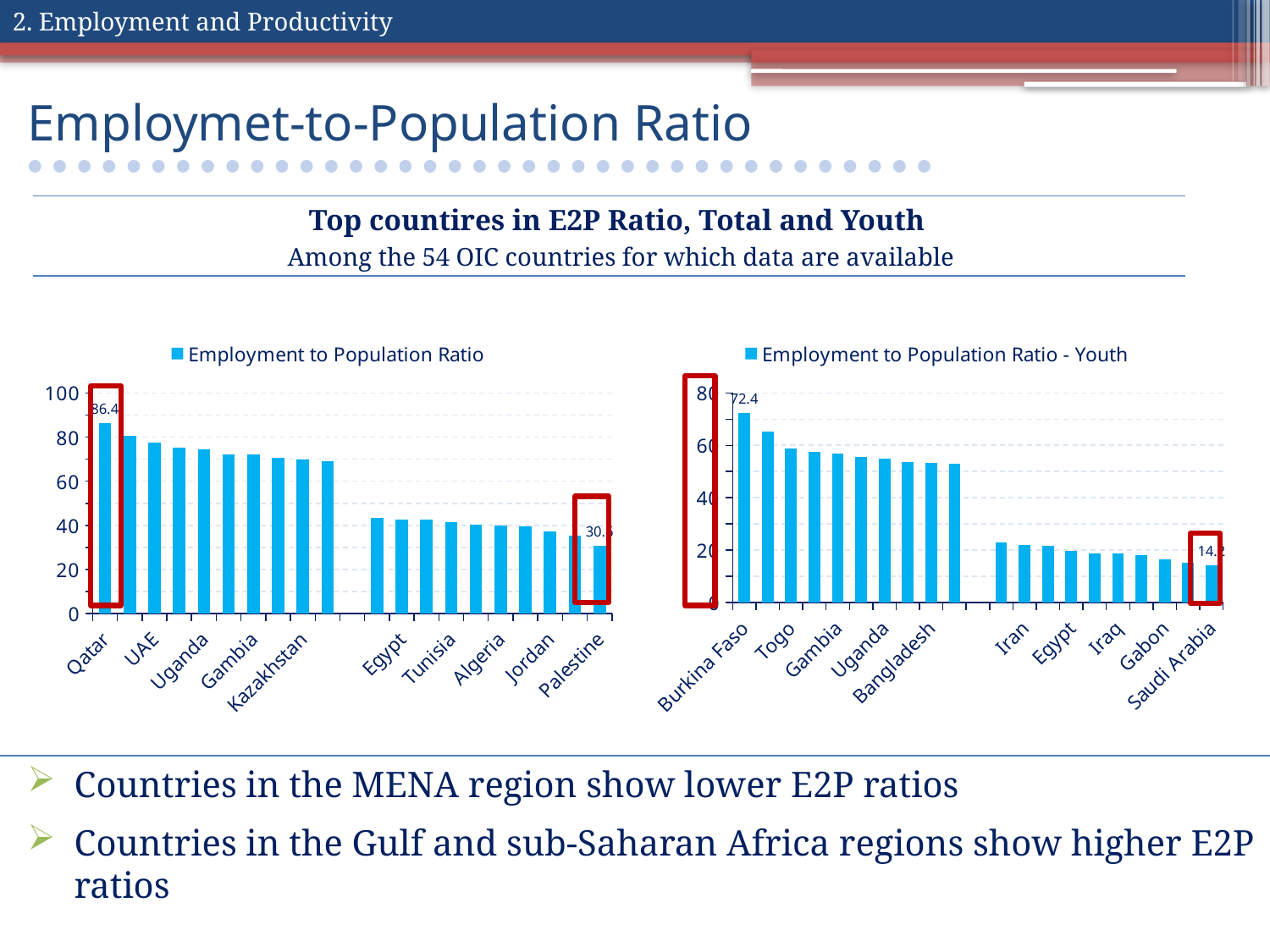
In the right chart (Employment to Population Ratio - Youth), is the value for Iran greater or less than 40? less In the right chart (Employment to Population Ratio - Youth), which country has the lowest value? Saudi Arabia In the left chart (Employment to Population Ratio), which labelled country has the lowest value? Palestine In the right chart (Employment to Population Ratio - Youth), what is the value for Burkina Faso? 72.4 In the left chart (Employment to Population Ratio), what is the value for Qatar? 86.4 In the left chart (Employment to Population Ratio), which labelled country has the highest value? Qatar In the left chart (Employment to Population Ratio), is the value for Egypt greater or less than 60? less What kind of chart is the right chart (Employment to Population Ratio - Youth)? bar chart In the right chart (Employment to Population Ratio - Youth), which country has the highest value? Burkina Faso In the left chart (Employment to Population Ratio), which is larger, the value for Uganda or the value for Jordan? Uganda In the left chart (Employment to Population Ratio), do the values rise or fall from left to right along the x axis? fall In the right chart (Employment to Population Ratio - Youth), is the value for Togo greater or less than 40? greater